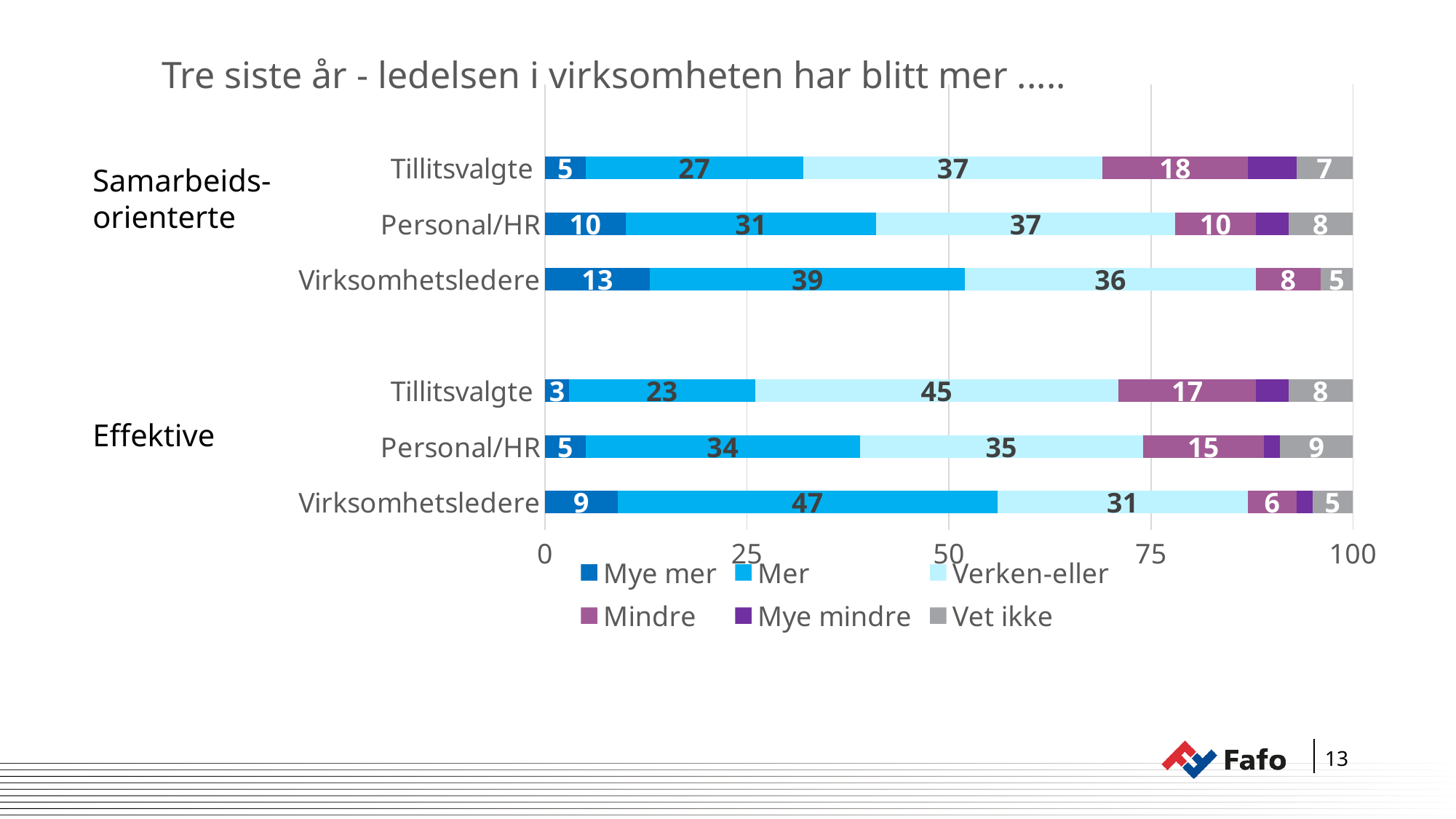
What is the 'Mer' value for Virksomhetsledere under Effektive? 47 What is the 'Mye mer' value for Virksomhetsledere under Samarbeidsorienterte? 13 Which group has the highest 'Mer' value across all bars? Virksomhetsledere (Effektive) What is the 'Verken-eller' value for Tillitsvalgte under Effektive? 45 Which bar has the lowest 'Mye mer' value? Tillitsvalgte (Effektive) What is the title of the chart? Tre siste år - ledelsen i virksomheten har blitt mer ….. Which is larger: the 'Mindre' value for Tillitsvalgte under Effektive or for Personal/HR under Effektive? Tillitsvalgte What is the 'Mindre' value for Tillitsvalgte under Samarbeidsorienterte? 18 How many series does the legend list? 6 What kind of chart is shown on the slide? Stacked bar chart What is the 'Vet ikke' value for Personal/HR under Effektive? 9 What is the difference between the 'Mer' values for Virksomhetsledere under Effektive and Virksomhetsledere under Samarbeidsorienterte? 8